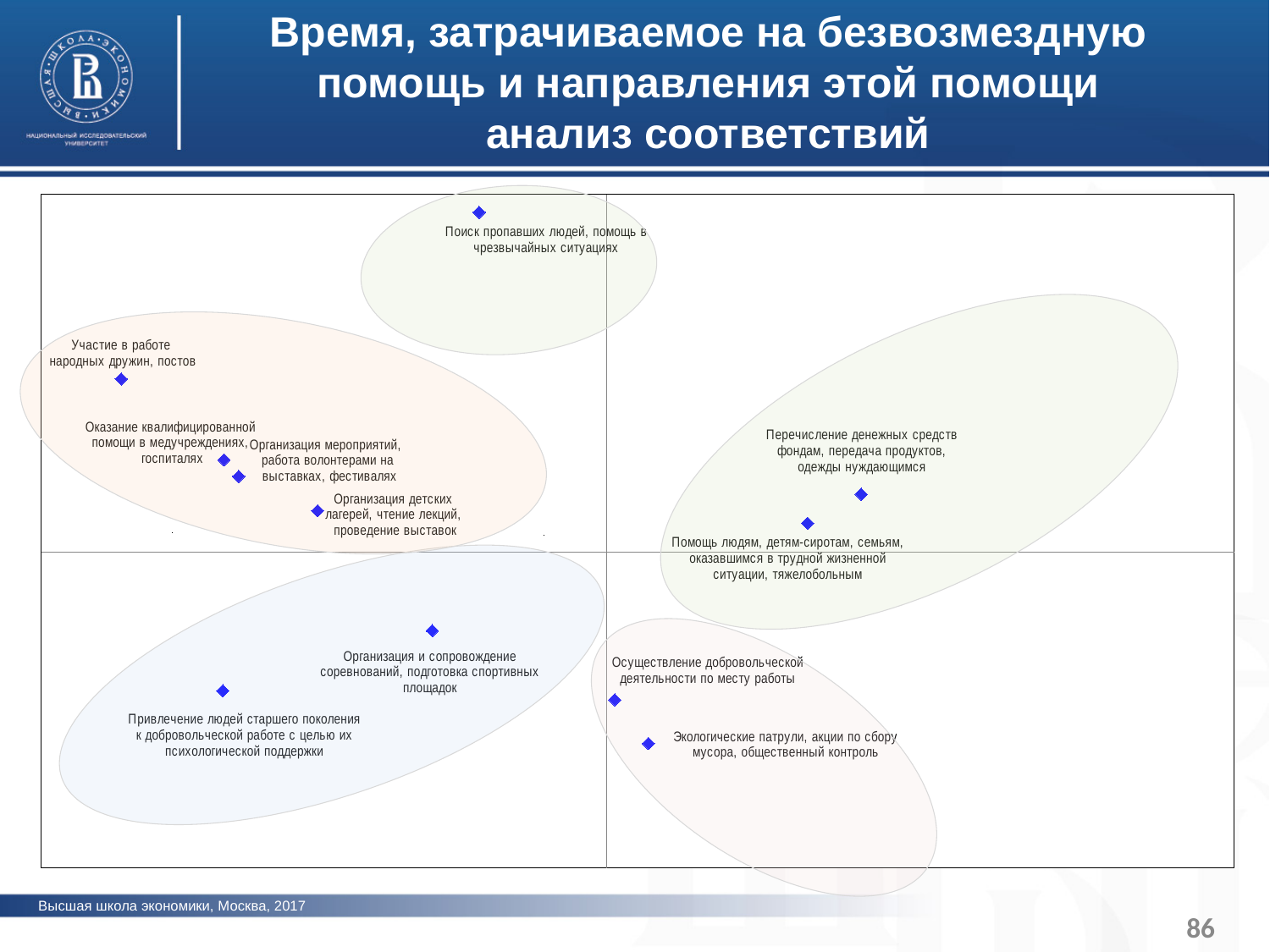
Which data point is positioned highest on the chart? Поиск пропавших людей, помощь в чрезвычайных ситуациях Which point is positioned higher on the chart: 'Участие в работе народных дружин, постов' or 'Привлечение людей старшего поколения к добровольческой работе'? Участие в работе народных дружин, постов How many data points are inside the bottom-left ellipse? 2 How many shaded ellipse groupings are drawn on the chart? 5 In which quadrant of the chart is 'Перечисление денежных средств фондам' located? upper right What is the title of the slide containing the chart? Время, затрачиваемое на безвозмездную помощь и направления этой помощи анализ соответствий How many data points are plotted on the chart? 11 Which data point is positioned furthest to the left on the chart? Участие в работе народных дружин, постов What kind of chart is shown on the slide? scatter chart Which point is positioned further to the right: 'Помощь людям, детям-сиротам, семьям' or 'Организация детских лагерей, чтение лекций, проведение выставок'? Помощь людям, детям-сиротам, семьям Which data point is positioned furthest to the right on the chart? Перечисление денежных средств фондам, передача продуктов, одежды нуждающимся Which data point is positioned lowest on the chart? Экологические патрули, акции по сбору мусора, общественный контроль